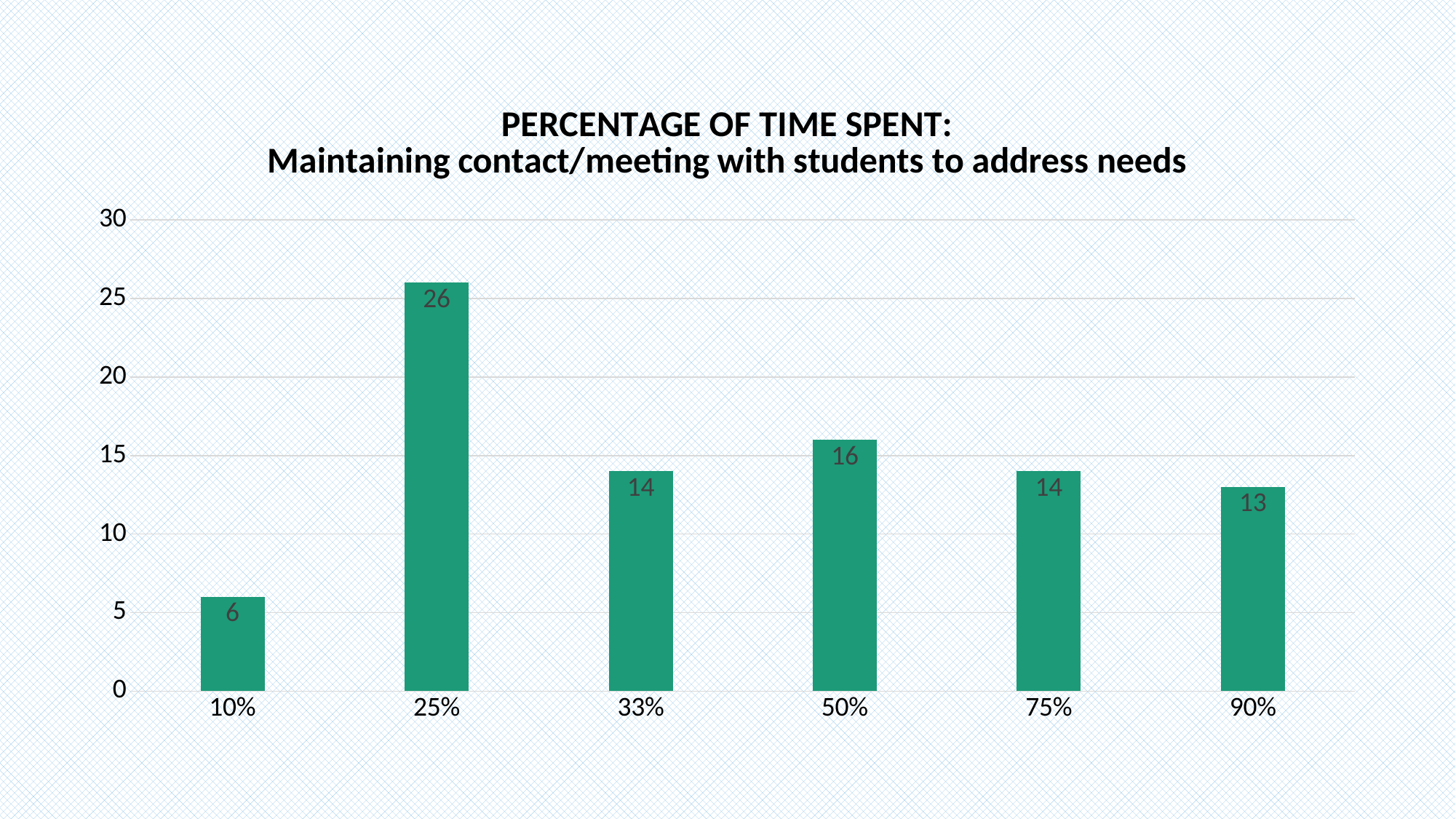
What is the value for the 50% category? 16 How many categories are shown on the x axis? 6 Which category has the lowest value? 10% What is the difference between the values for 25% and 50%? 10 What is the value for the 10% category? 6 Is the value for 25% greater or less than 20? greater Which is larger, the value for 50% or the value for 75%? 50% What is the value for the 25% category? 26 What is the value for the 90% category? 13 What kind of chart is shown on the slide? bar chart What is the title of the chart? PERCENTAGE OF TIME SPENT: Maintaining contact/meeting with students to address needs Which category has the highest value? 25%